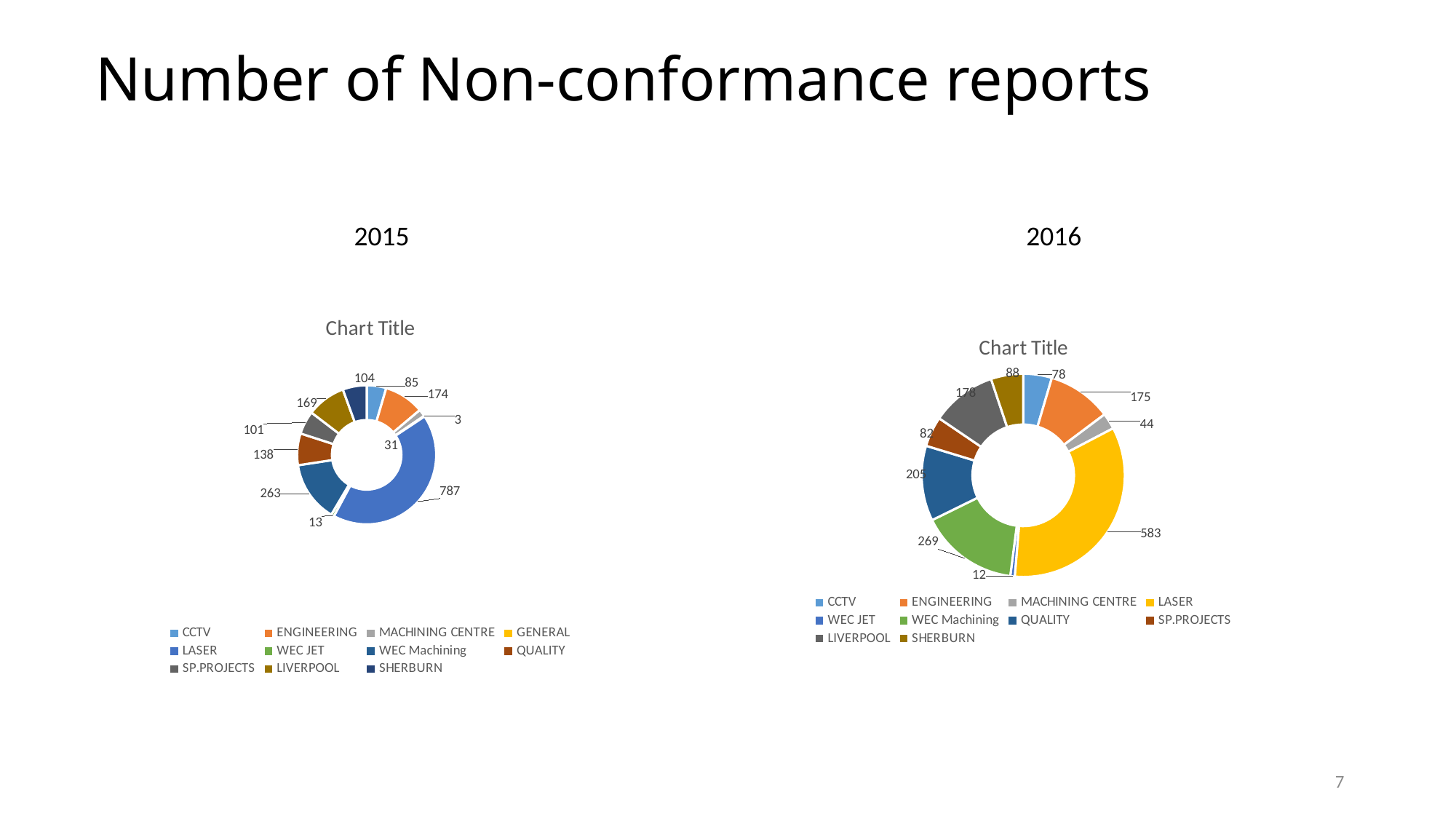
What is the difference between the LASER value in the 2015 chart and the LASER value in the 2016 chart? 204 In the 2015 chart, what is the value for LASER? 787 In the 2016 chart, which category has the smallest value? WEC JET In the 2016 chart, what is the value for ENGINEERING? 175 In the 2015 chart, which category has the largest value? LASER How many entries does the legend of the 2015 chart list? 11 In the 2016 chart, what is the value for LASER? 583 In the 2016 chart, what is the difference between WEC Machining and QUALITY? 64 In the 2015 chart, which category has the smallest value? GENERAL How many entries does the legend of the 2016 chart list? 10 In the 2016 chart, which is larger: WEC Machining or QUALITY? WEC Machining What kind of chart is the 2015 chart? Doughnut (pie) chart